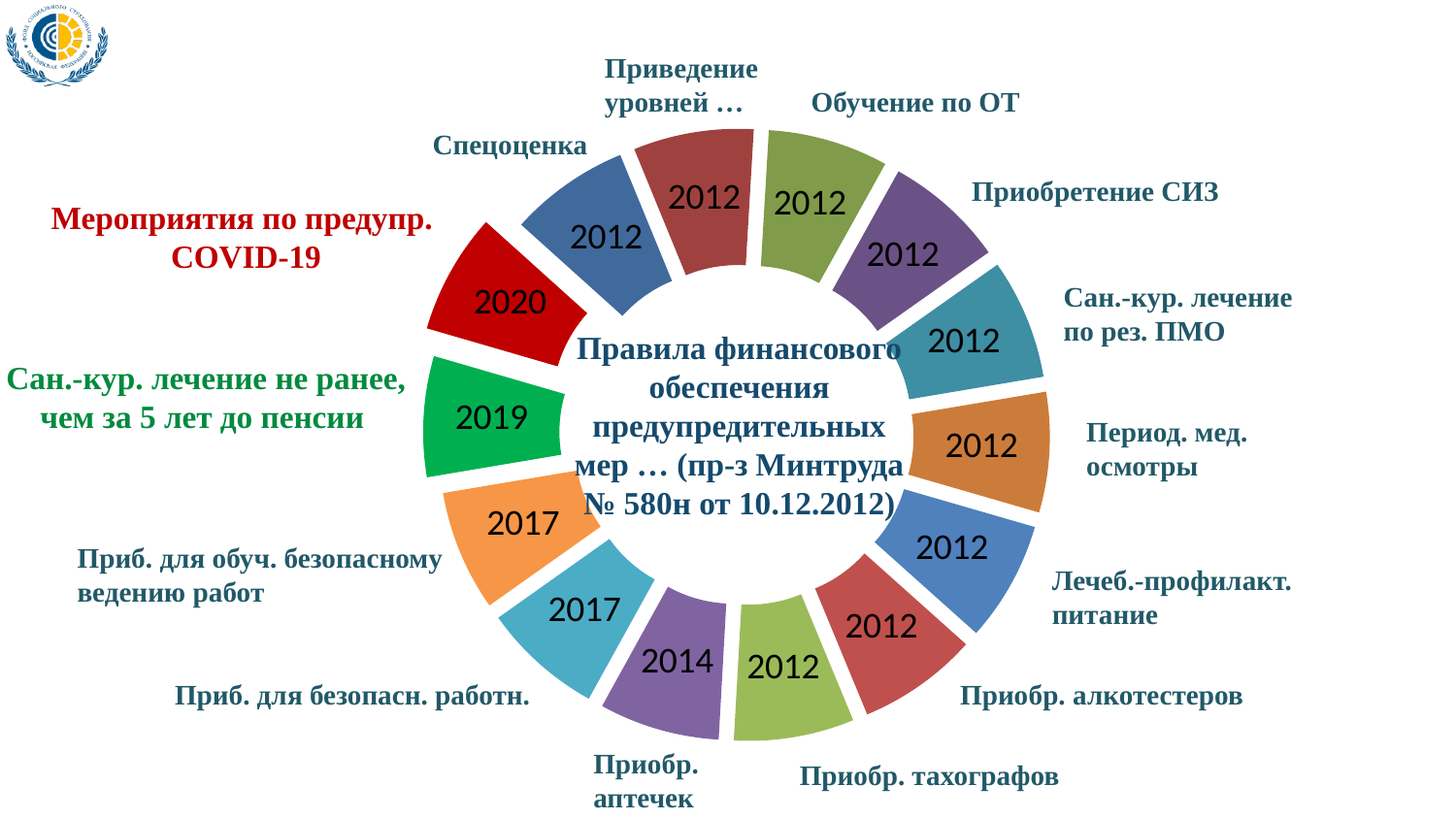
Which segment has the later year: 'Приобр. аптечек' or 'Приб. для обуч. безопасному ведению работ'? Приб. для обуч. безопасному ведению работ Which segment carries the latest year? Мероприятия по предупр. COVID-19 How many segments are labelled with the year 2012? 9 What text is written in the centre of the doughnut chart? Правила финансового обеспечения предупредительных мер … (пр-з Минтруда № 580н от 10.12.2012) What kind of chart is shown on the slide? Doughnut (pie) chart What year is shown on the segment labelled 'Спецоценка'? 2012 How many years separate the 'Мероприятия по предупр. COVID-19' segment (2020) from the 'Обучение по ОТ' segment (2012)? 8 What year is shown on the segment labelled 'Приб. для безопасн. работн.'? 2017 What year is shown on the segment labelled 'Мероприятия по предупр. COVID-19'? 2020 What year is shown on the segment labelled 'Сан.-кур. лечение не ранее, чем за 5 лет до пенсии'? 2019 What year is shown on the segment labelled 'Приобр. аптечек'? 2014 How many segments does the doughnut chart have? 14